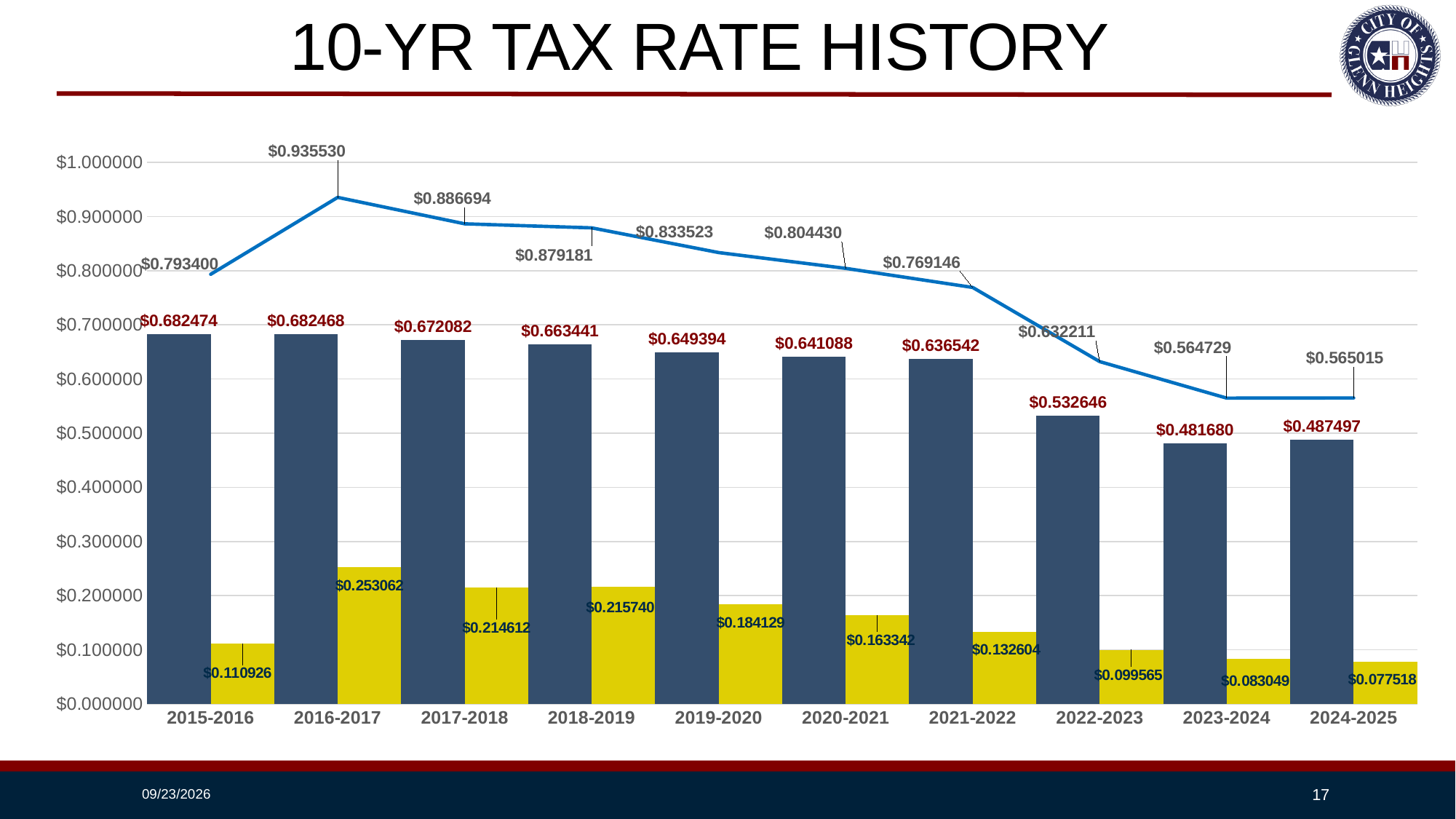
What kind of chart is shown on the slide? Combined bar and line chart What is the value of the dark blue bar for 2015-2016? $0.682474 Does the blue line rise or fall from 2016-2017 to 2023-2024? Fall In which year does the blue line reach its highest value? 2016-2017 What is the difference between the blue line values for 2016-2017 and 2015-2016? $0.142130 What is the value of the yellow bar for 2017-2018? $0.214612 Is the blue line value for 2022-2023 greater or less than $0.600000? greater In which year is the yellow bar the lowest? 2024-2025 What is the title of the chart? 10-YR TAX RATE HISTORY Which is larger, the dark blue bar for 2023-2024 or for 2024-2025? 2024-2025 What value does the blue line show for 2021-2022? $0.769146 How many fiscal years are shown on the x axis? 10